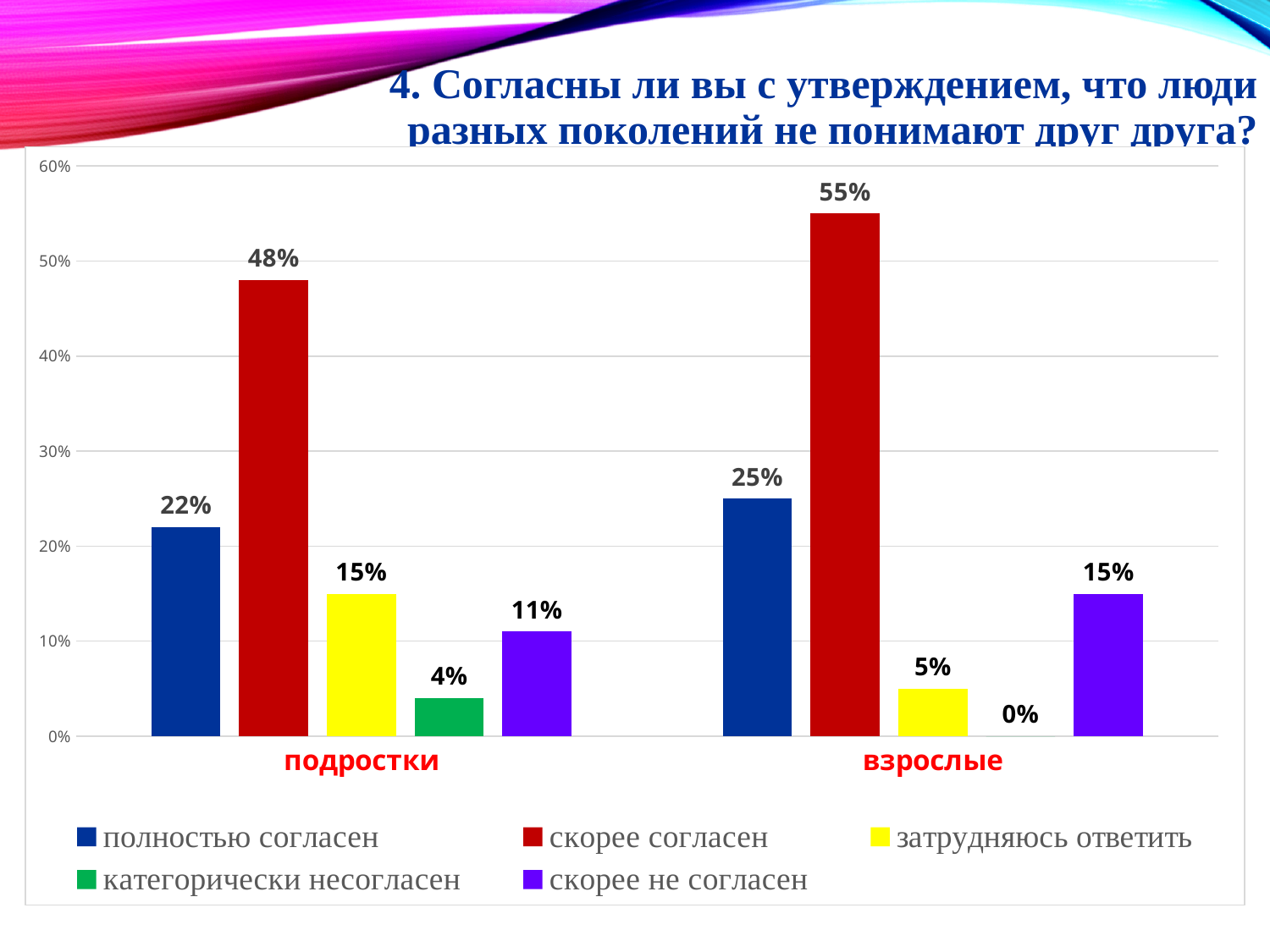
What is the value for "категорически несогласен" among взрослые? 0% How many series does the legend list? 5 Which group has a higher value for "скорее не согласен", подростки or взрослые? взрослые Which response has the highest value among взрослые? скорее согласен Which colour represents "затрудняюсь ответить" in the legend? yellow What is the difference between the "скорее согласен" values for взрослые and подростки? 7% How many groups are shown on the x axis? 2 What percentage of взрослые answered "полностью согласен"? 25% Is the value for "полностью согласен" among подростки greater or less than 20%? greater What type of chart is shown on the slide? bar chart Which response has the lowest value among подростки? категорически несогласен What percentage of подростки answered "скорее согласен"? 48%